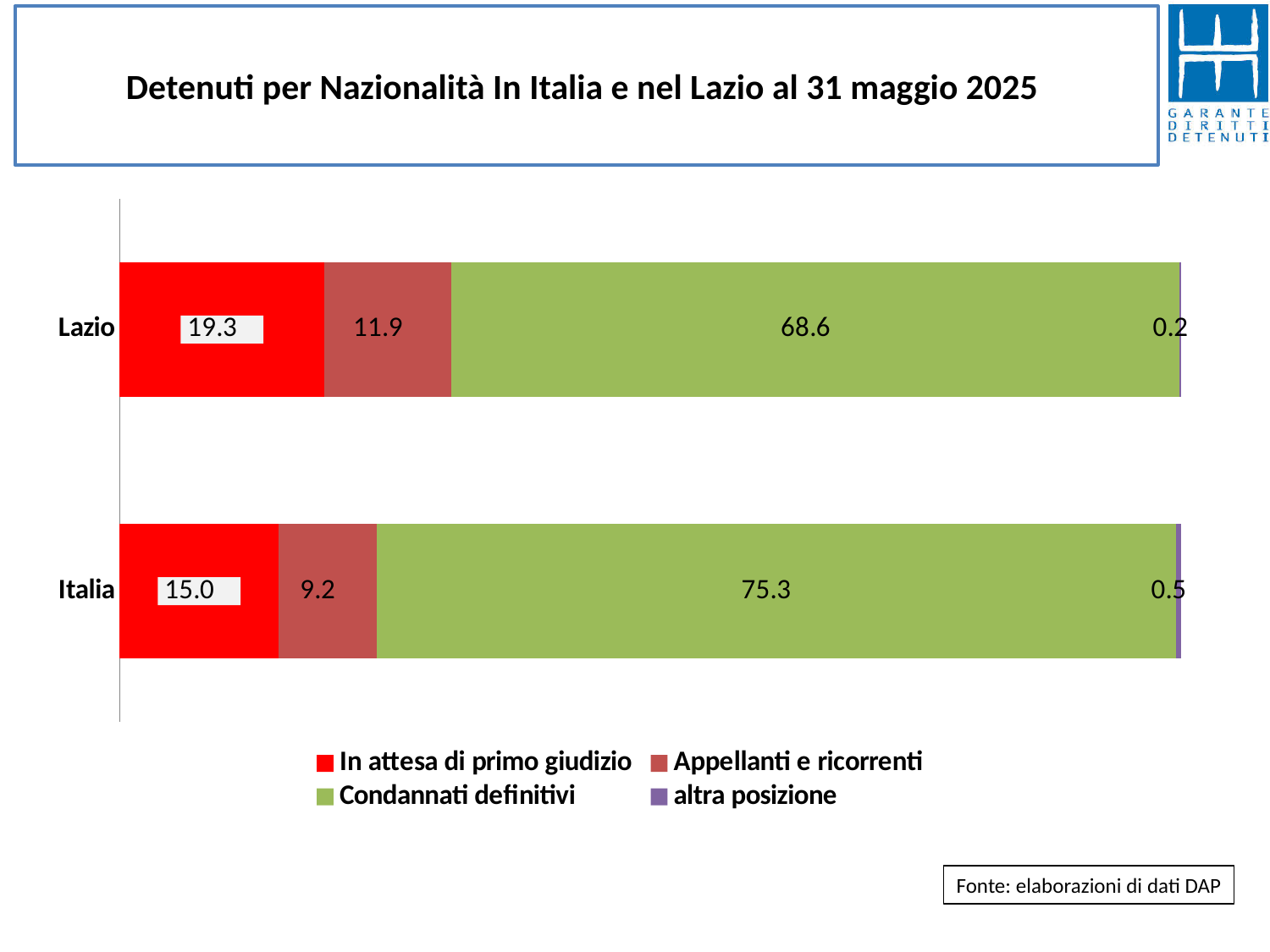
Which series has the smallest value for Italia? altra posizione What is the value for 'In attesa di primo giudizio' for Lazio? 19.3 Which has the larger 'In attesa di primo giudizio' value, Lazio or Italia? Lazio What is the value for 'altra posizione' for Italia? 0.5 What is the value for 'Appellanti e ricorrenti' for Lazio? 11.9 What kind of chart is shown on the slide? Stacked bar chart How many series does the legend list? 4 Which series has the largest value for Lazio? Condannati definitivi What is the total of the stacked bar for Lazio? 100.0 What is the difference between the 'Condannati definitivi' values for Italia and Lazio? 6.7 What is the value for 'Condannati definitivi' for Italia? 75.3 How many categories are shown on the chart? 2